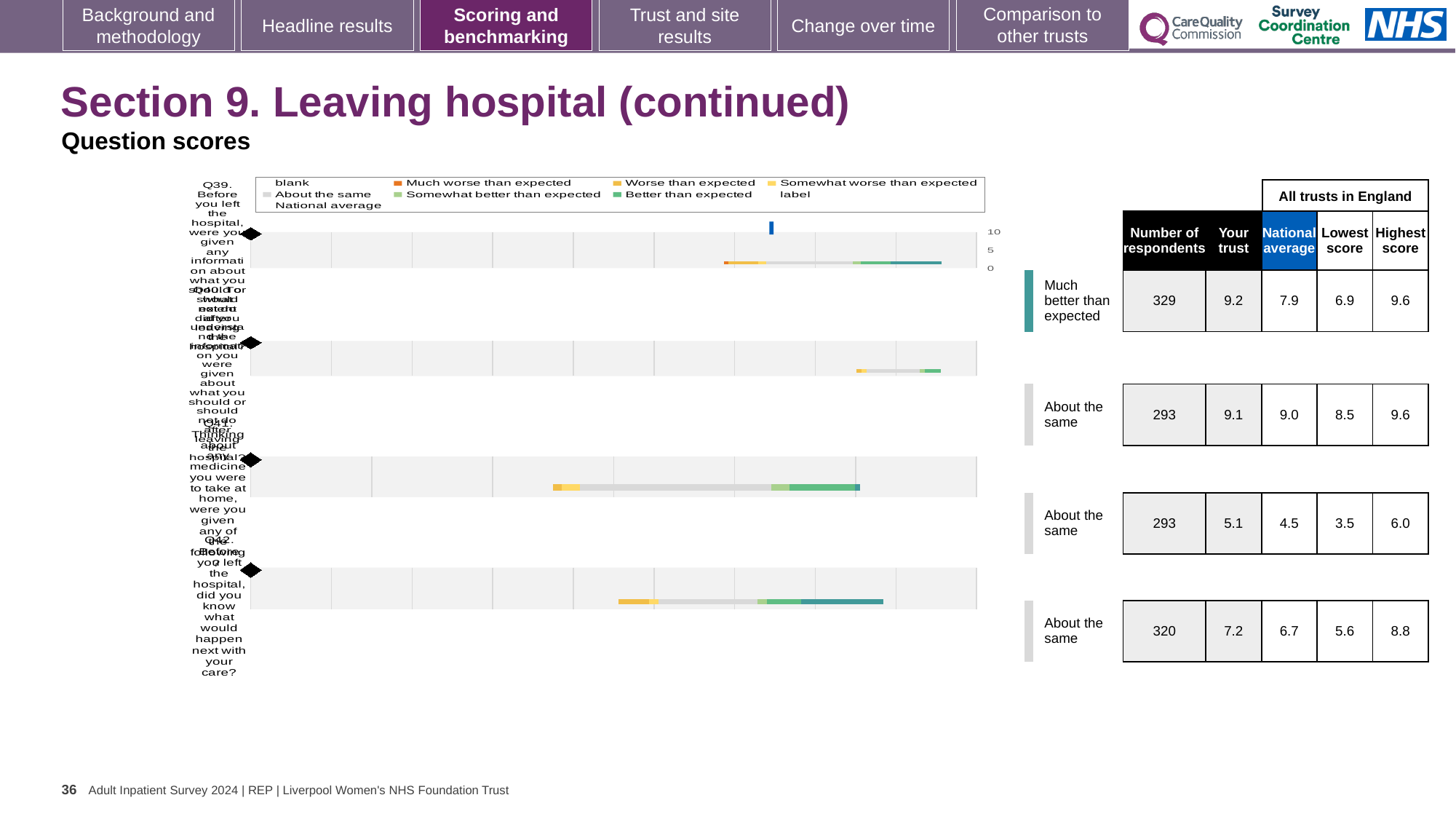
How many respondents are listed for Q42 (the bottom row of the chart)? 320 What is the national average score for Q39 (the top row of the chart)? 7.9 What kind of chart is used to show the question scores on this slide? bar chart Which row of the chart has the lowest 'Your trust' score? the third row How many questions (rows) are plotted in the chart? 4 For Q39 (the top row), which is larger: the 'Your trust' score or the national average? Your trust What is the difference between the 'Your trust' score and the national average for Q39 (the top row)? 1.3 What is the highest score among all trusts in England for Q42 (the bottom row)? 8.8 What is the 'Your trust' score for Q39 (the top row of the chart)? 9.2 Which row of the chart has the highest 'Your trust' score? Q39 (the top row) What benchmark category is shown next to Q39 (the top row of the chart)? Much better than expected Is the 'Your trust' score marker for Q39 (the top row) greater or less than 5 on the axis? greater